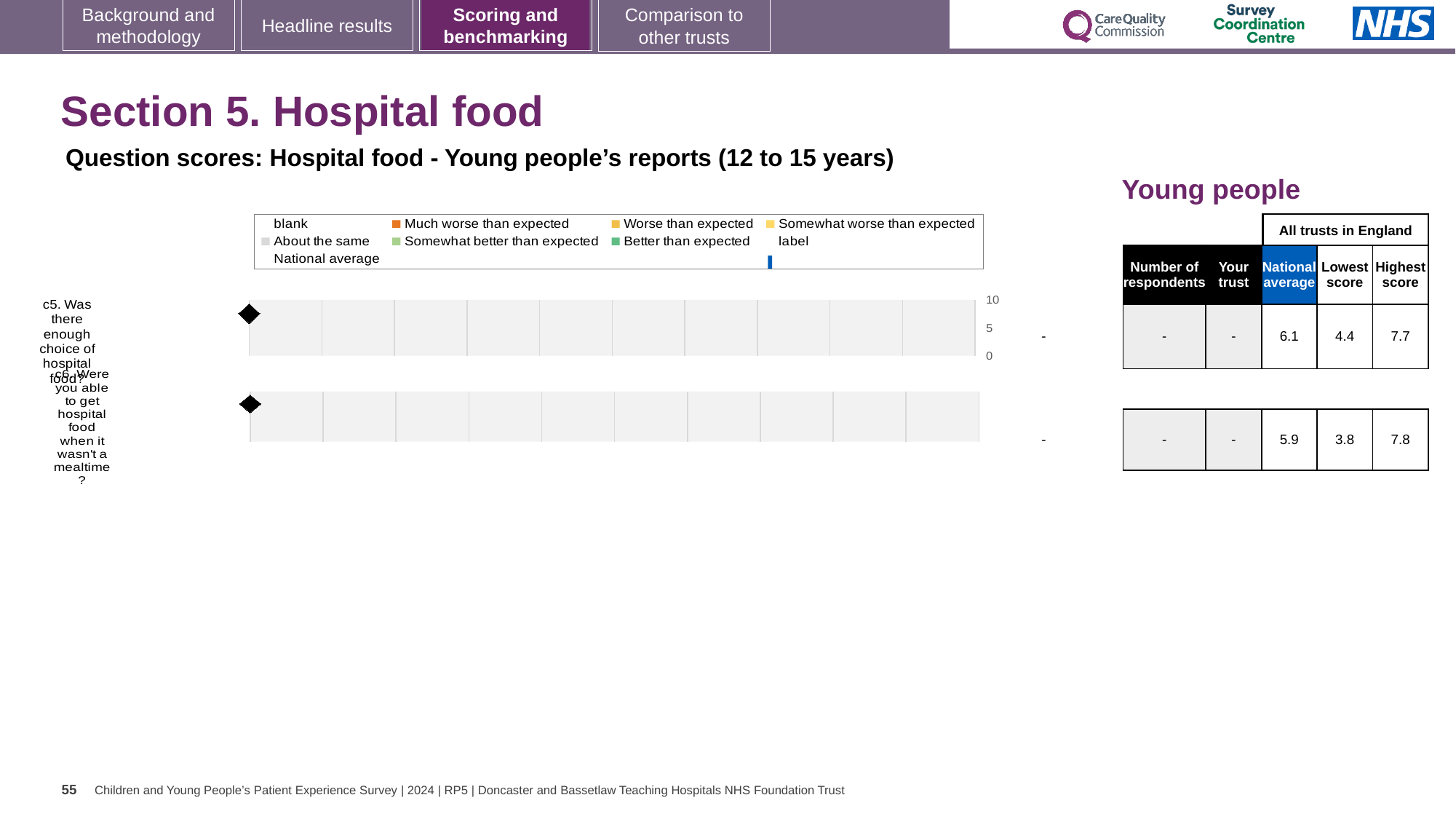
In the Young people table, what is the national average score for c5 (Was there enough choice of hospital food?)? 6.1 In the Young people table, what is the highest score for c5? 7.7 What is the highest tick value shown on the chart's score axis? 10 What is the difference between the highest score and the lowest score for c5? 3.3 What is the difference between the national average scores for c5 and c6? 0.2 How many survey questions are plotted as bars in the chart? 2 Which question has the higher national average score, c5 or c6? c5 In the Young people table, what is the highest score for c6? 7.8 What value is shown in the 'Your trust' column for c5? - Which question has the lower lowest score, c5 or c6? c6 What kind of chart is shown on the slide? bar chart In the Young people table, what is the lowest score for c6 (Were you able to get hospital food when it wasn't a mealtime?)? 3.8